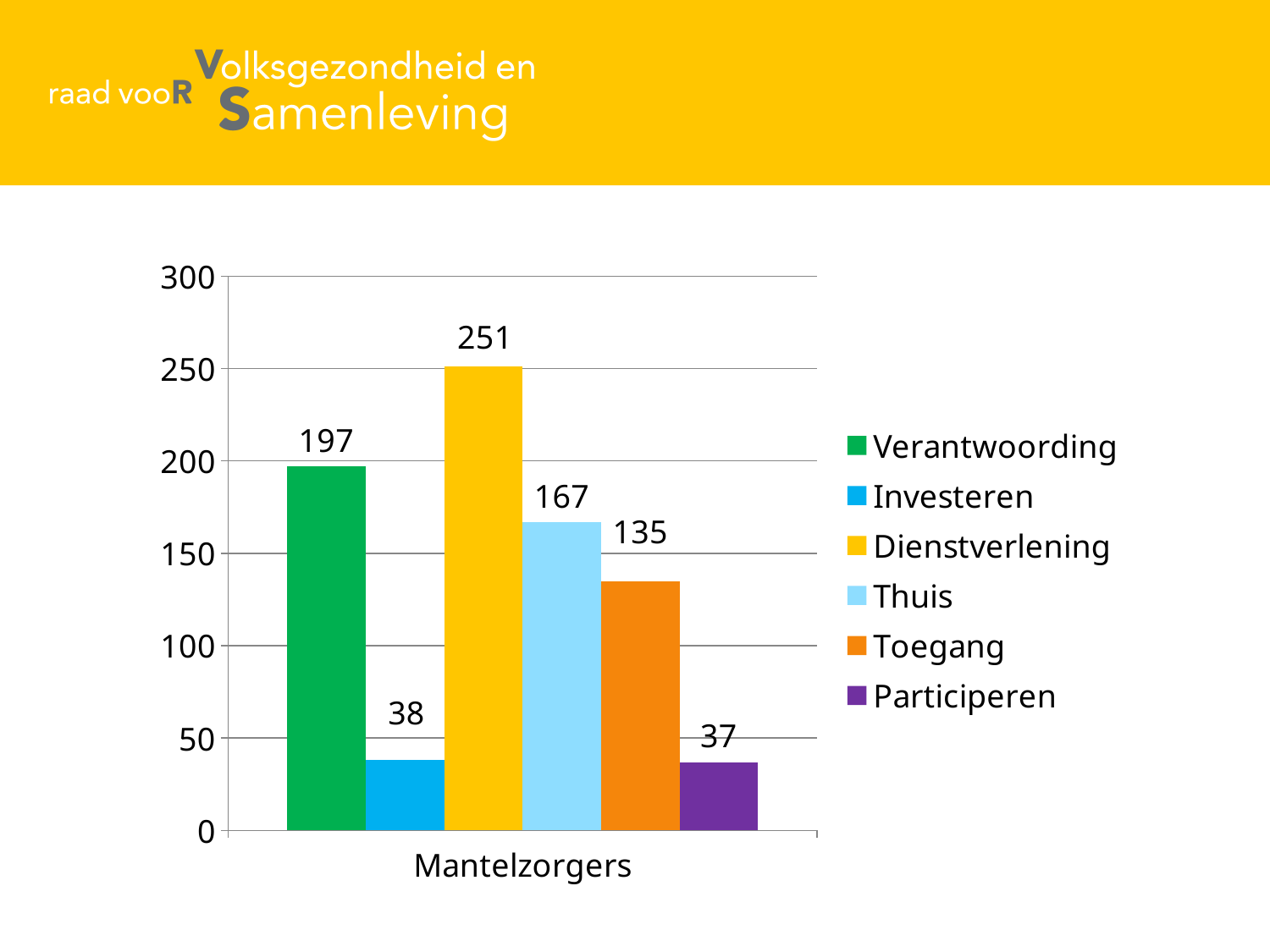
What is the value for Toegang? 135 How many series does the legend list? 6 What is the difference between the values for Thuis and Toegang? 32 Which is larger, the value for Verantwoording or the value for Thuis? Verantwoording What is the value for Dienstverlening? 251 What is the category label shown on the x axis? Mantelzorgers Which series has the highest value? Dienstverlening What is the value for Verantwoording in the Mantelzorgers chart? 197 What is the difference between the values for Dienstverlening and Verantwoording? 54 What kind of chart is shown on the slide? Bar chart Which series has the lowest value? Participeren What is the value for Thuis? 167